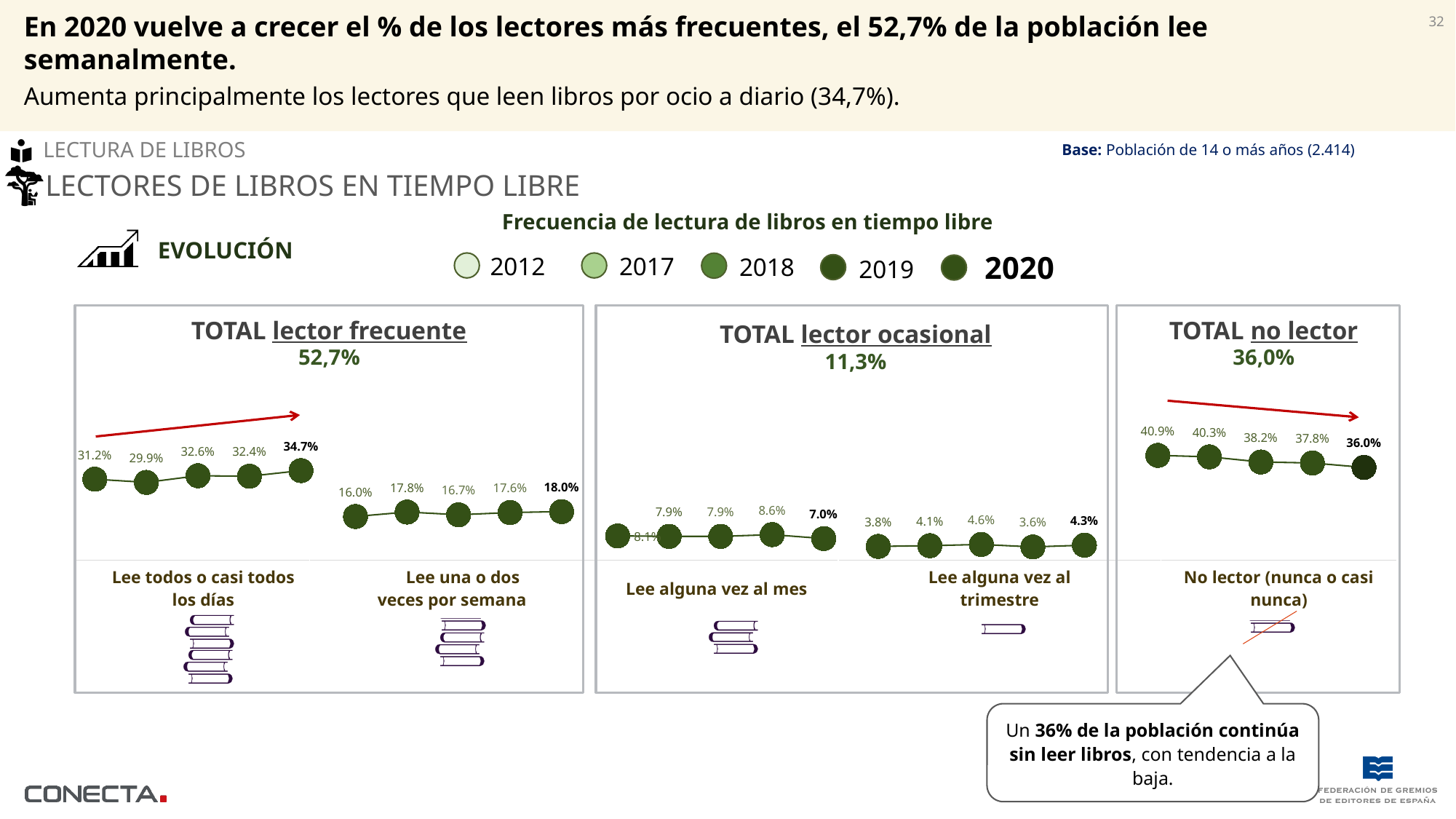
In the 'No lector (nunca o casi nunca)' chart, what is the difference between the 2012 value and the 2020 value? 4.9% What kind of chart is used to show the evolution of 'Lee una o dos veces por semana'? line chart In the 'No lector (nunca o casi nunca)' chart, do the values rise or fall from 2012 to 2020? fall In the 'Lee todos o casi todos los días' chart, what is the value for 2020? 34.7% How many years does the legend list for the frequency charts? 5 In the 'Lee todos o casi todos los días' chart, what is the difference between the 2020 value and the 2019 value? 2.3% In the 'Lee alguna vez al mes' chart, which year has the highest value? 2019 In the 'Lee alguna vez al trimestre' chart, what is the value for 2018? 4.6% In the 'Lee todos o casi todos los días' chart, which year has the lowest value? 2017 In the 'No lector (nunca o casi nunca)' chart, what is the value for 2012? 40.9% In the 'Lee una o dos veces por semana' chart, what is the value for 2017? 17.8% In the 'Lee alguna vez al trimestre' chart, which is larger, the value for 2019 or the value for 2020? 2020